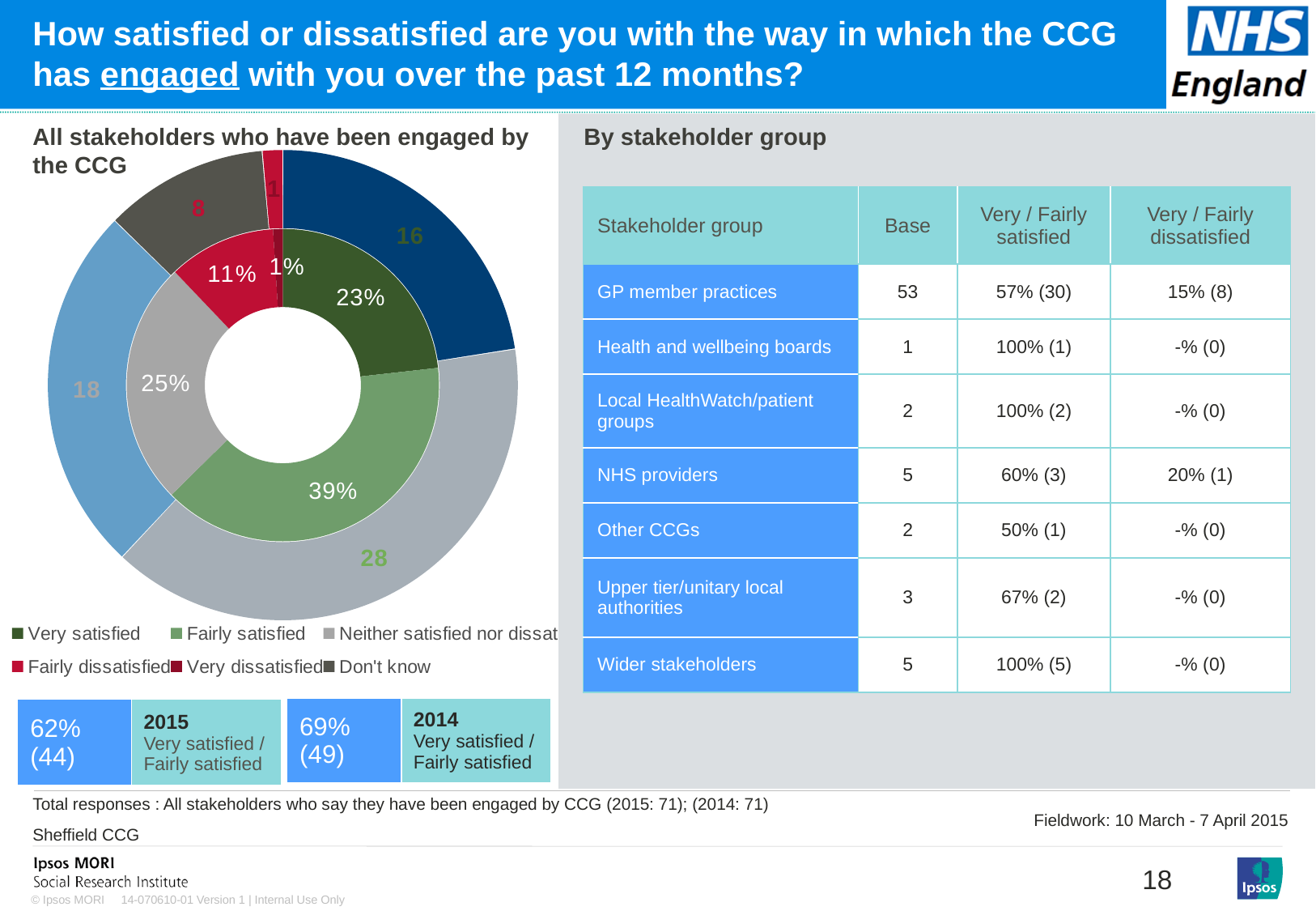
In the doughnut chart, what percentage of stakeholders are Fairly satisfied? 39% In the doughnut chart, what percentage of stakeholders are Neither satisfied nor dissatisfied? 25% In the doughnut chart, what percentage of stakeholders are Very dissatisfied? 1% What is the title of the doughnut chart on the left of the slide? All stakeholders who have been engaged by the CCG Which response category has the largest share in the doughnut chart? Fairly satisfied According to the slide, what is the combined Very satisfied / Fairly satisfied percentage for 2015? 62% (44) In the doughnut chart, what percentage of stakeholders are Very satisfied? 23% How many response categories does the legend of the doughnut chart list? 6 What type of chart is used to show satisfaction among all stakeholders who have been engaged by the CCG? Doughnut (pie) chart In the doughnut chart, which is larger: the share for Neither satisfied nor dissatisfied or the share for Fairly dissatisfied? Neither satisfied nor dissatisfied In the doughnut chart, what percentage of stakeholders are Fairly dissatisfied? 11% In the doughnut chart, how many percentage points higher is Fairly satisfied than Very satisfied? 16 percentage points